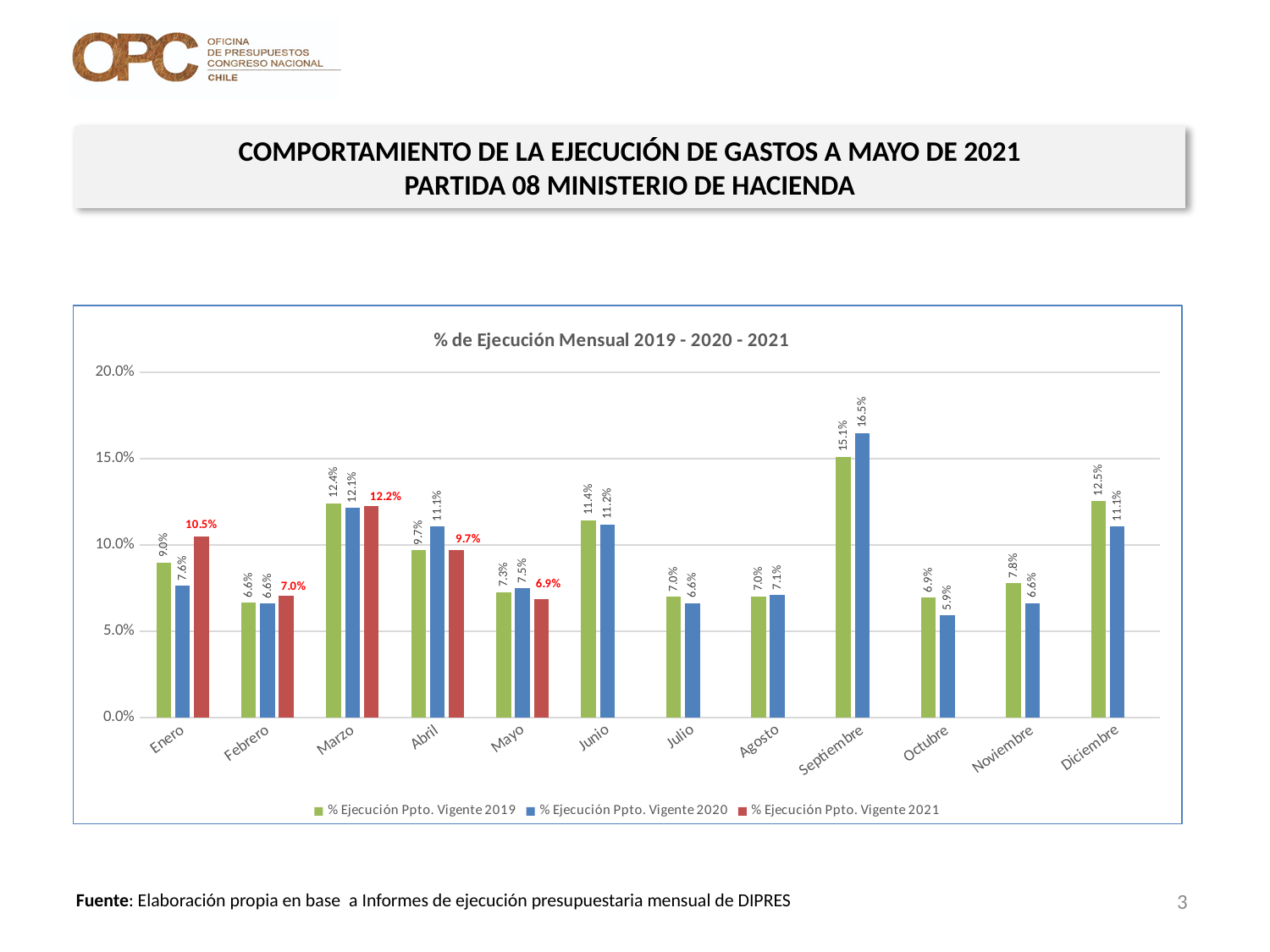
What is the difference between the 2020 and 2019 values in Septiembre? 1.4% Which month has the lowest value for % Ejecución Ppto. Vigente 2020? Octubre What kind of chart is shown? Bar chart How many months are shown on the x axis? 12 What is the value for % Ejecución Ppto. Vigente 2019 in Diciembre? 12.5% Which is larger in Abril: the 2020 value or the 2019 value? 2020 Which month has the highest value for % Ejecución Ppto. Vigente 2019? Septiembre What is the value for % Ejecución Ppto. Vigente 2021 in Enero? 10.5% Is the value for % Ejecución Ppto. Vigente 2019 in Marzo greater or less than 10.0%? greater How many series does the legend list? 3 What is the title of the chart? % de Ejecución Mensual 2019 - 2020 - 2021 What is the value for % Ejecución Ppto. Vigente 2020 in Septiembre? 16.5%